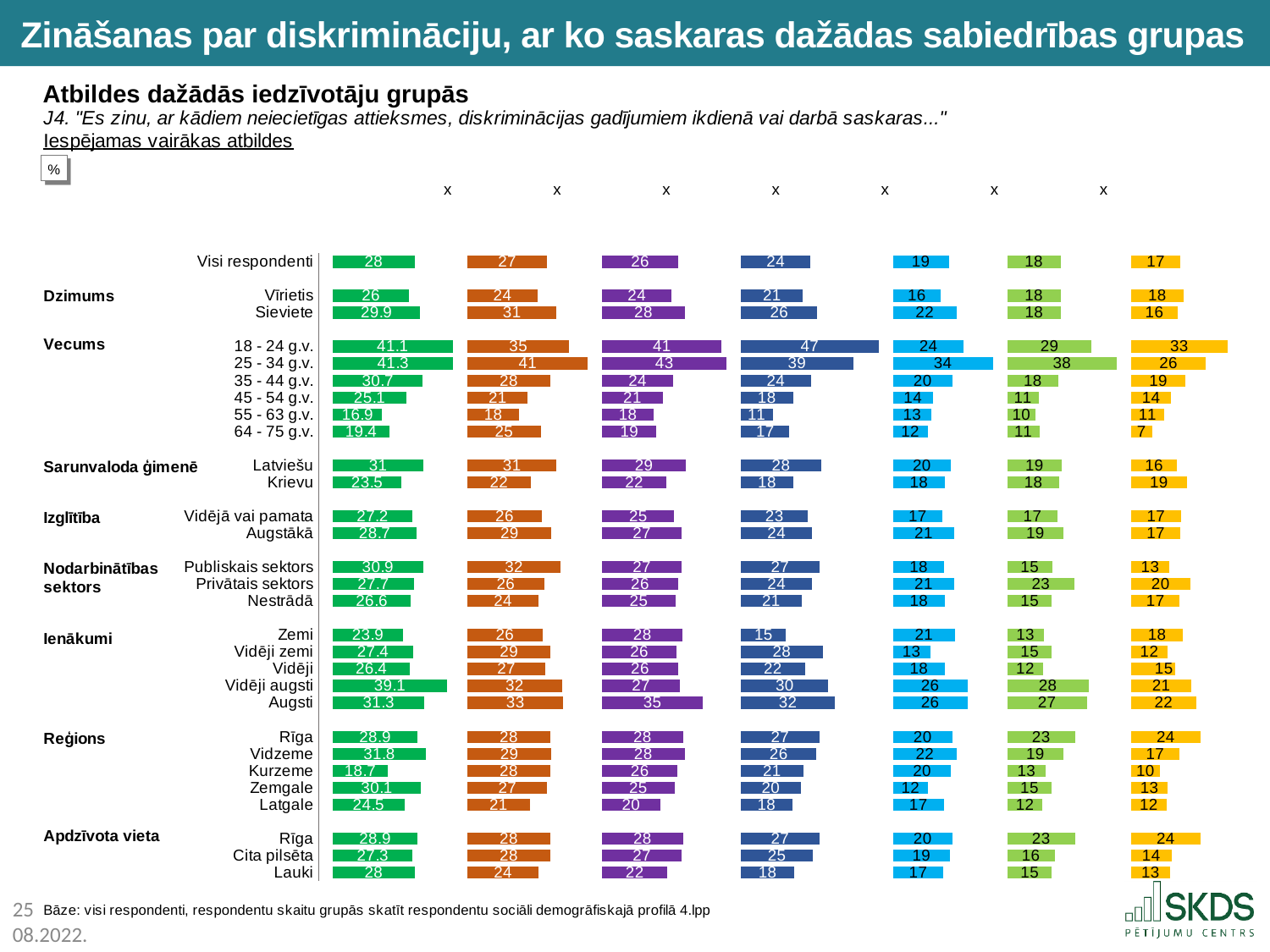
What is the value of the green (first) bar for Visi respondenti? 28 How many rows are shown under the Ienākumi group? 5 What is the value of the green (first) bar for Vidēji augsti income? 39.1 What is the value of the dark blue (fourth) bar for the 18 - 24 g.v. age group? 47 What type of chart is shown on the slide? Bar chart What is the value of the yellow (last) bar for the 64 - 75 g.v. age group? 7 Among the Vecums (age) groups, which has the highest value in the green (first) bar series? 25 - 34 g.v. In the purple (third) bar series, what is the difference between Augsti and Zemi income groups? 7 In the green (first) bar series, which is larger: Latviešu or Krievu? Latviešu Among the Reģions rows, which region has the lowest value in the green (first) bar series? Kurzeme In the orange (second) bar series, what is the difference between Sieviete and Vīrietis? 7 How many bar series (colours) are plotted for each row? 7